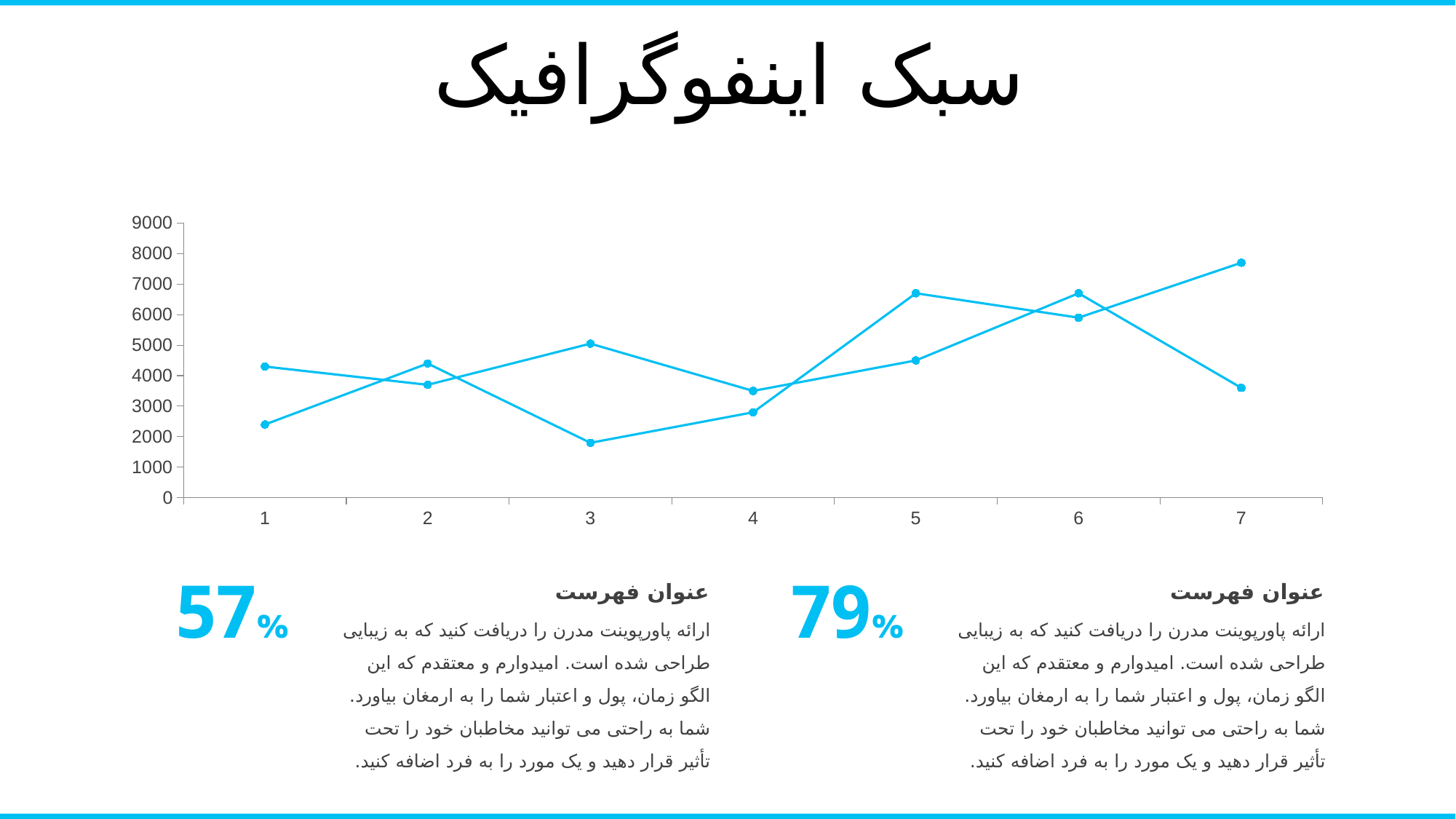
How many categories are shown on the x axis of the chart? 7 At which category does the highest point on the whole chart occur? 7 Is the highest plotted value at category 1 greater or less than 4000? greater Is the lowest plotted value at category 3 greater or less than 2000? less Is the highest plotted value at category 5 greater or less than 6000? greater What kind of chart is shown on the slide? line chart At which category does the lowest point on the whole chart occur? 3 How many lines are plotted on the chart? 2 What is the highest value shown on the y axis of the chart? 9000